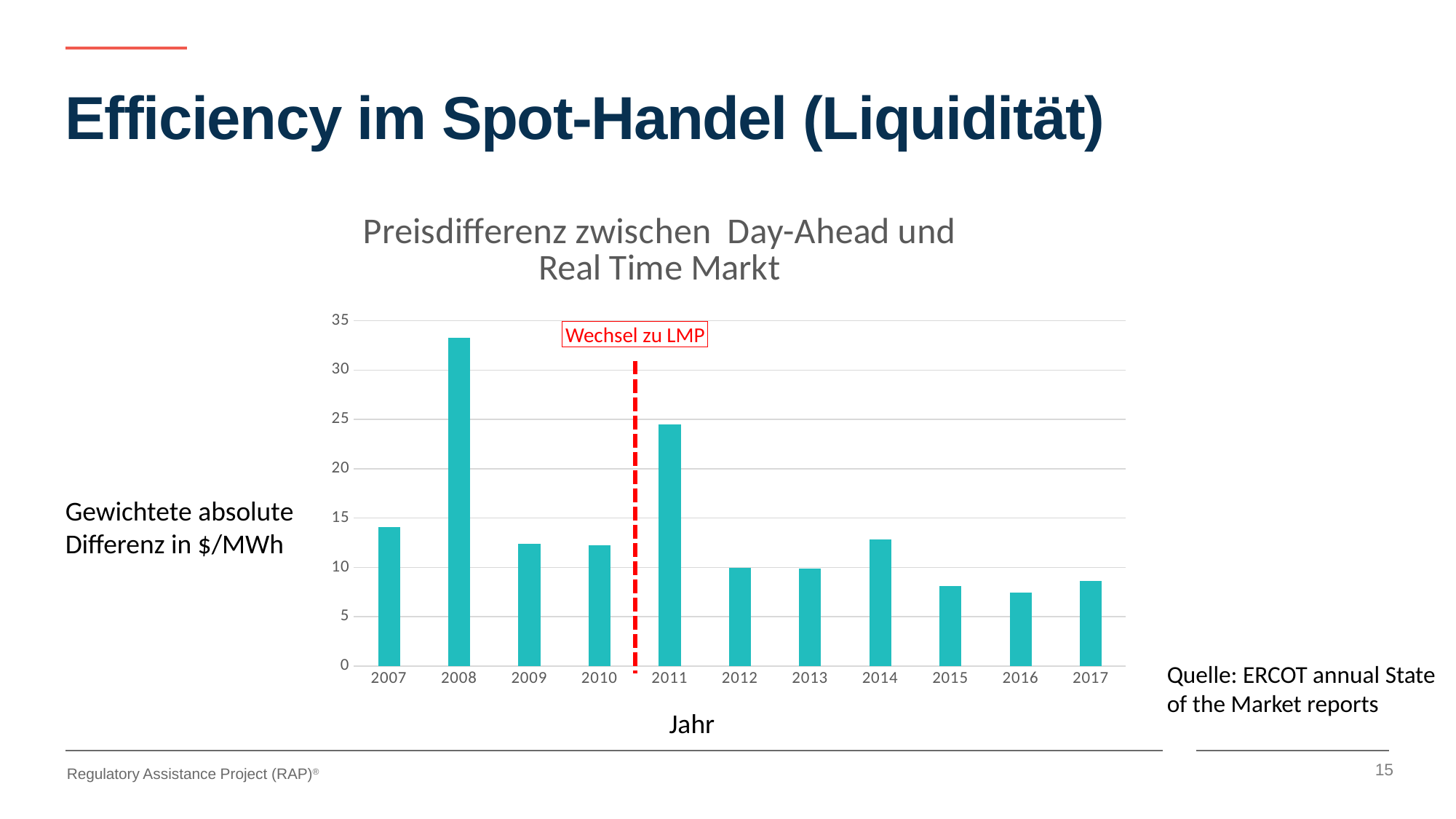
What does the red dashed line annotation between 2010 and 2011 say? Wechsel zu LMP How many years are shown on the x axis? 11 Do the values generally rise or fall from 2011 to 2017? fall Which year has the larger value, 2008 or 2011? 2008 Is the value for 2008 greater or less than 30? greater Which year has the highest weighted absolute price difference? 2008 Which year has the lowest weighted absolute price difference? 2016 What kind of chart is shown on the slide? bar chart Is the value for 2011 greater or less than 20? greater Is the value for 2014 greater or less than 10? greater Which year has the larger value, 2007 or 2014? 2007